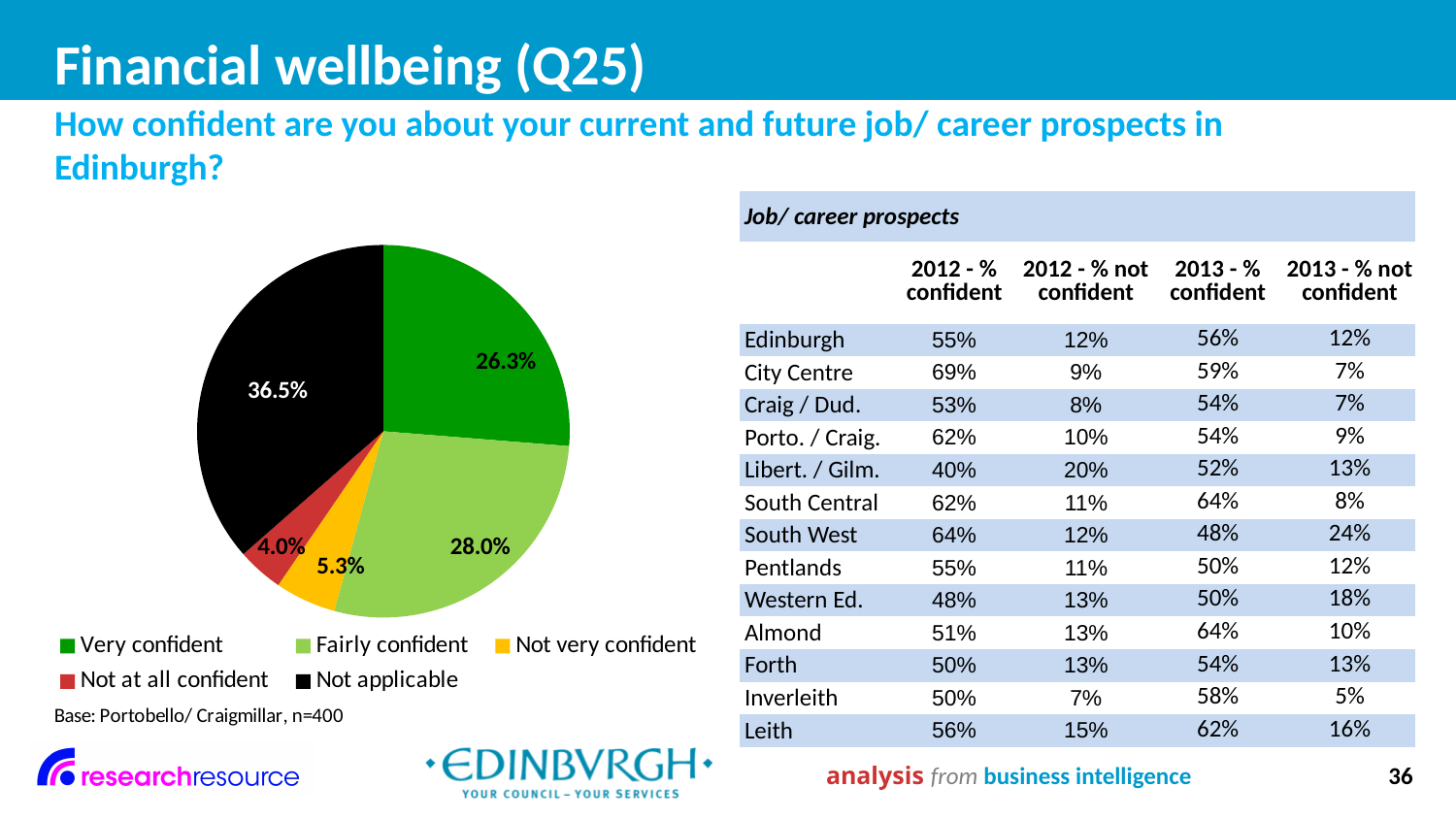
What colour is the 'Not applicable' slice in the pie chart? Black Which category has the largest slice in the pie chart? Not applicable Which is larger in the pie chart: 'Not very confident' or 'Not at all confident'? Not very confident What percentage of the pie chart is 'Not applicable'? 36.5% Which category has the smallest slice in the pie chart? Not at all confident What percentage of respondents are 'Not very confident' in the pie chart? 5.3% What is the difference between the 'Fairly confident' and 'Very confident' slices in the pie chart? 1.7% What percentage of respondents are 'Very confident' in the pie chart? 26.3% What percentage of respondents are 'Not at all confident' in the pie chart? 4.0% How many categories does the pie chart legend list? 5 What type of chart is shown on the slide? Pie chart What percentage of respondents are 'Fairly confident' in the pie chart? 28.0%